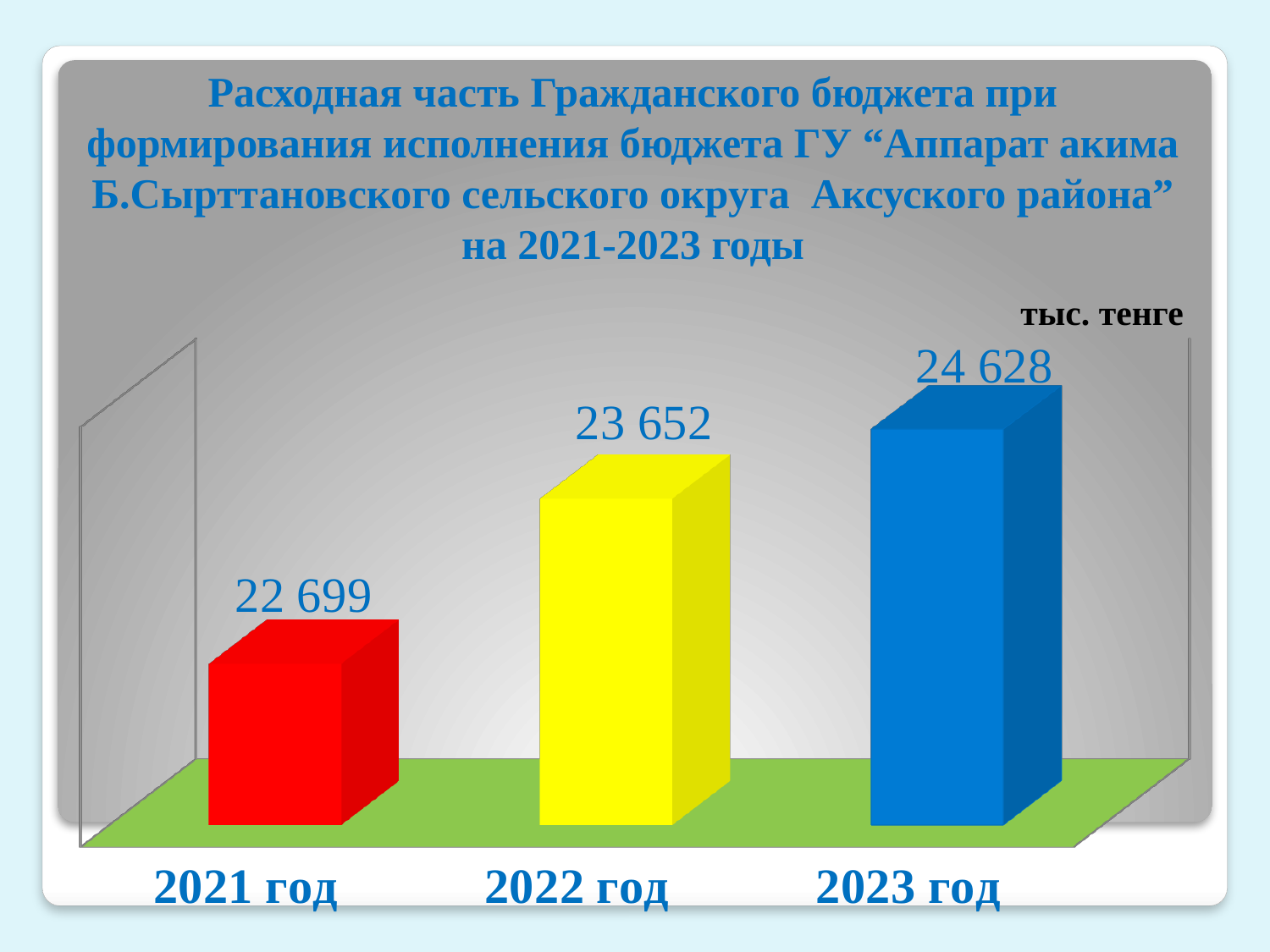
Which is larger, the value for 2022 год or the value for 2023 год? 2023 год What is the value for 2022 год? 23 652 What is the value for 2023 год? 24 628 Do the values rise or fall from 2021 год to 2023 год? rise What kind of chart is shown on the slide? bar chart What is the difference between the values for 2023 год and 2021 год? 1 929 Which year has the highest value? 2023 год What is the difference between the values for 2022 год and 2021 год? 953 What unit is indicated for the values on the chart? тыс. тенге How many years are shown on the chart? 3 What is the value for 2021 год? 22 699 Which year has the lowest value? 2021 год